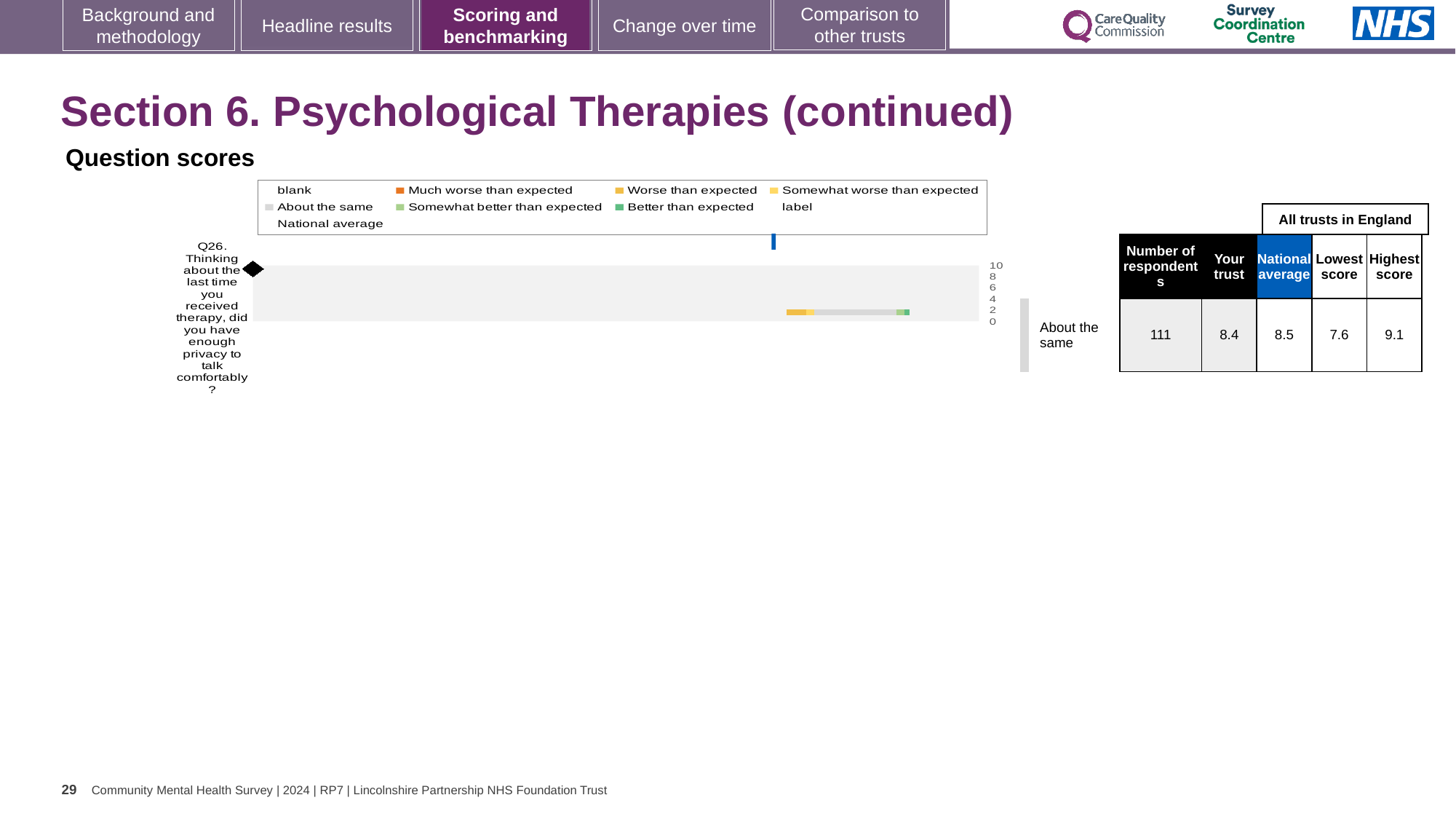
What is the lowest score among all trusts in England for Q26? 7.6 How many survey questions are plotted in the Question scores chart? 1 What is the 'Your trust' score for Q26 (privacy to talk comfortably during therapy)? 8.4 What is the highest score among all trusts in England for Q26? 9.1 Which is larger for Q26: the 'Your trust' score or the national average? National average What is the difference between the highest and lowest trust scores for Q26? 1.5 What is the national average score for Q26? 8.5 What benchmarking category is shown for Q26? About the same What kind of chart is used to show the Q26 question score? bar chart By how much does the national average exceed the 'Your trust' score for Q26? 0.1 What is the maximum value shown on the chart's score axis? 10 How many respondents answered Q26? 111